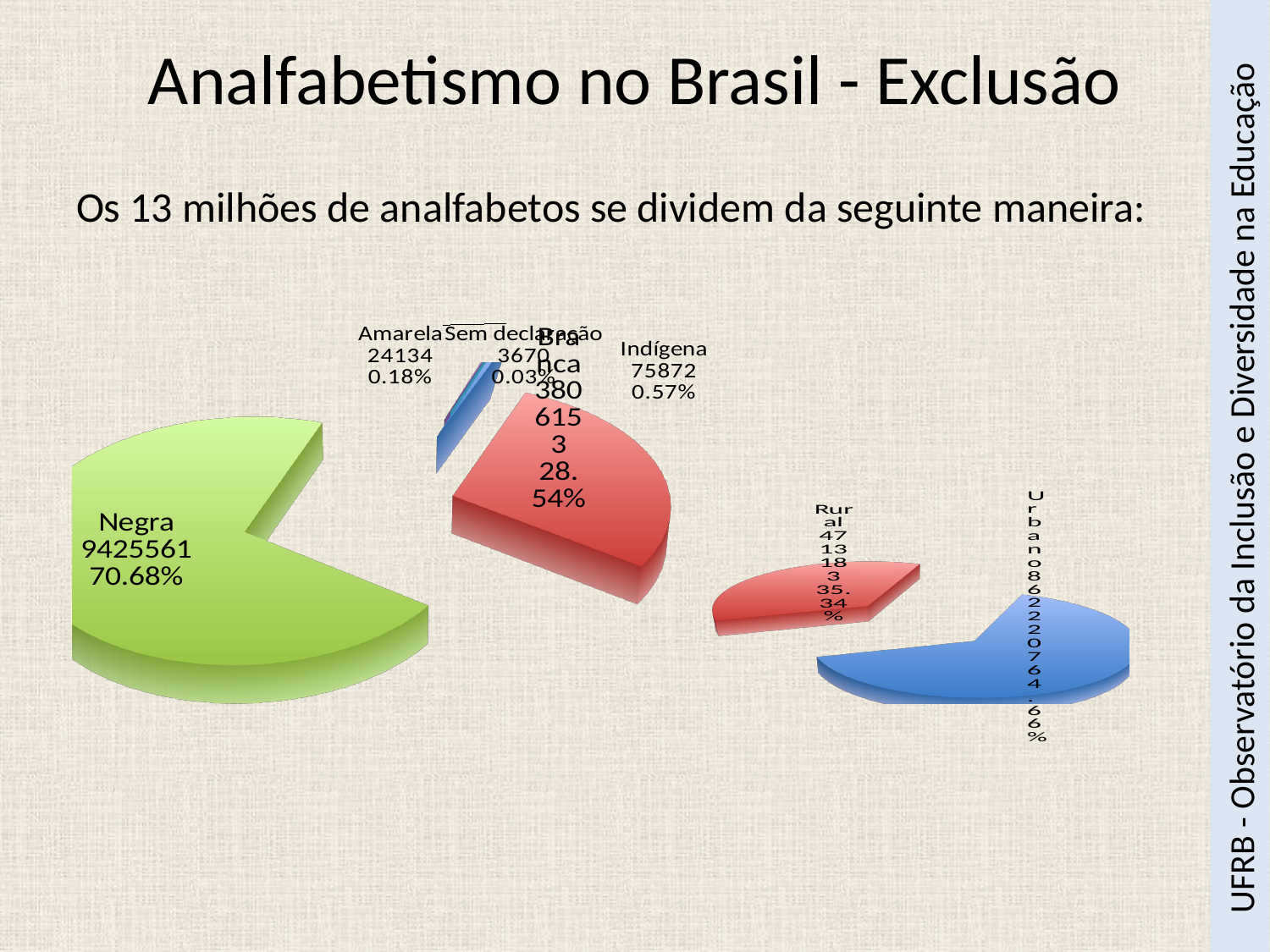
How many categories does the left pie chart show? 5 In the left pie chart, what percentage share does the Negra slice have? 70.68% In the left pie chart, which category has the smallest slice? Sem declaração In the left pie chart, what percentage is shown for Amarela? 0.18% In the left pie chart, which category has the largest slice? Negra In the right pie chart, which is larger, Rural or Urbano? Urbano In the left pie chart, what is the value shown for Negra? 9425561 What type of chart is used on this slide? Pie chart In the right pie chart, what percentage is shown for Rural? 35.34% In the left pie chart, what is the value shown for Indígena? 75872 In the right pie chart, what percentage is shown for Urbano? 64.66% In the left pie chart, what percentage is shown for Sem declaração? 0.03%